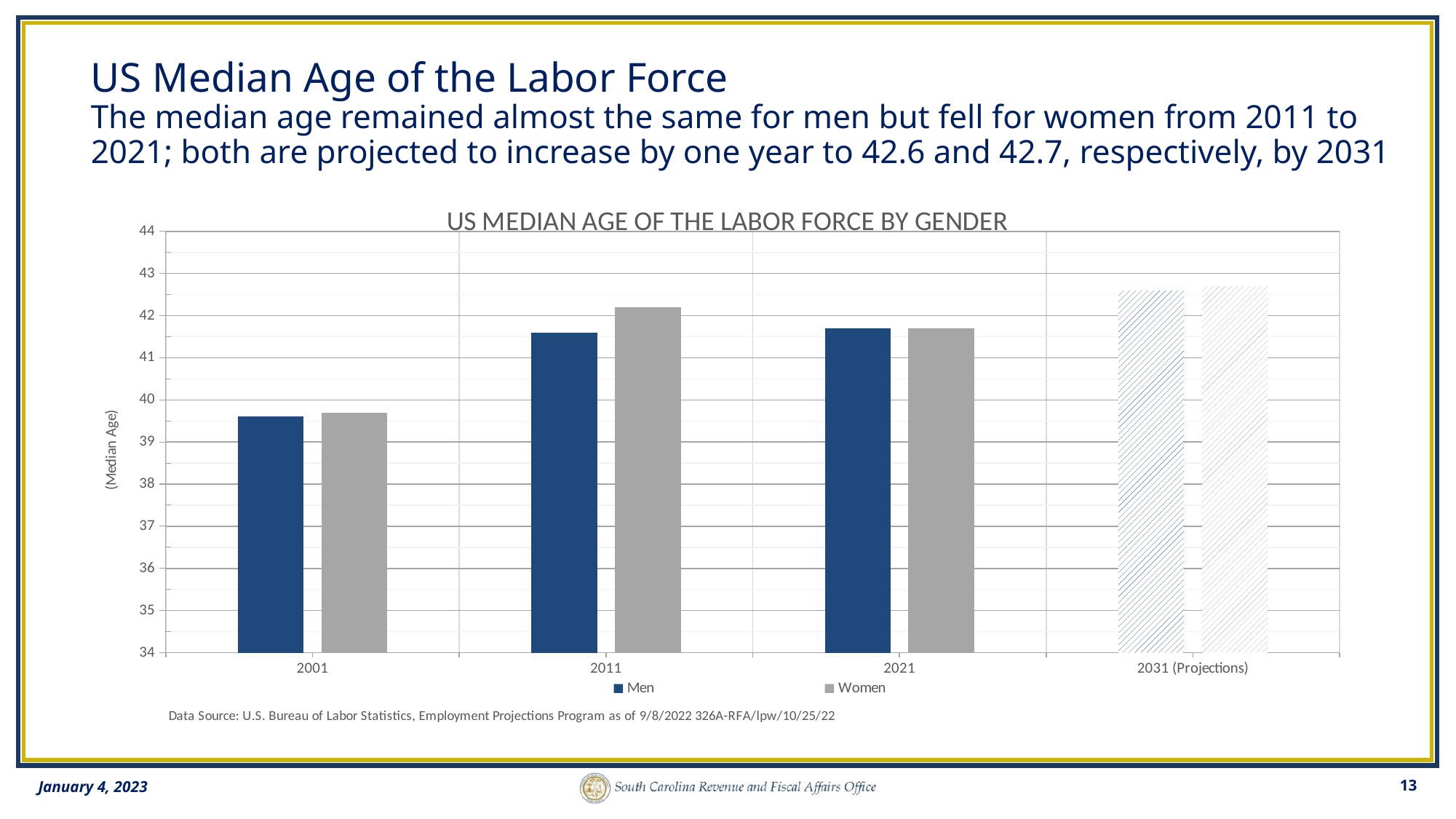
Is the median age for women in 2011 greater or less than 41? greater How many series does the legend list? 2 How many year categories are shown on the x axis? 4 What kind of chart is shown on the slide? bar chart What is the projected median age for women in 2031? 42.7 What is the difference between the projected 2031 median ages for women and men? 0.1 In 2011, which is larger, the median age for men or for women? Women What is the projected median age for men in 2031? 42.6 Is the median age for men in 2001 greater or less than 40? less What is the title of the chart? US MEDIAN AGE OF THE LABOR FORCE BY GENDER Which year has the lowest median age for men? 2001 Is the median age for men in 2021 greater or less than 41? greater